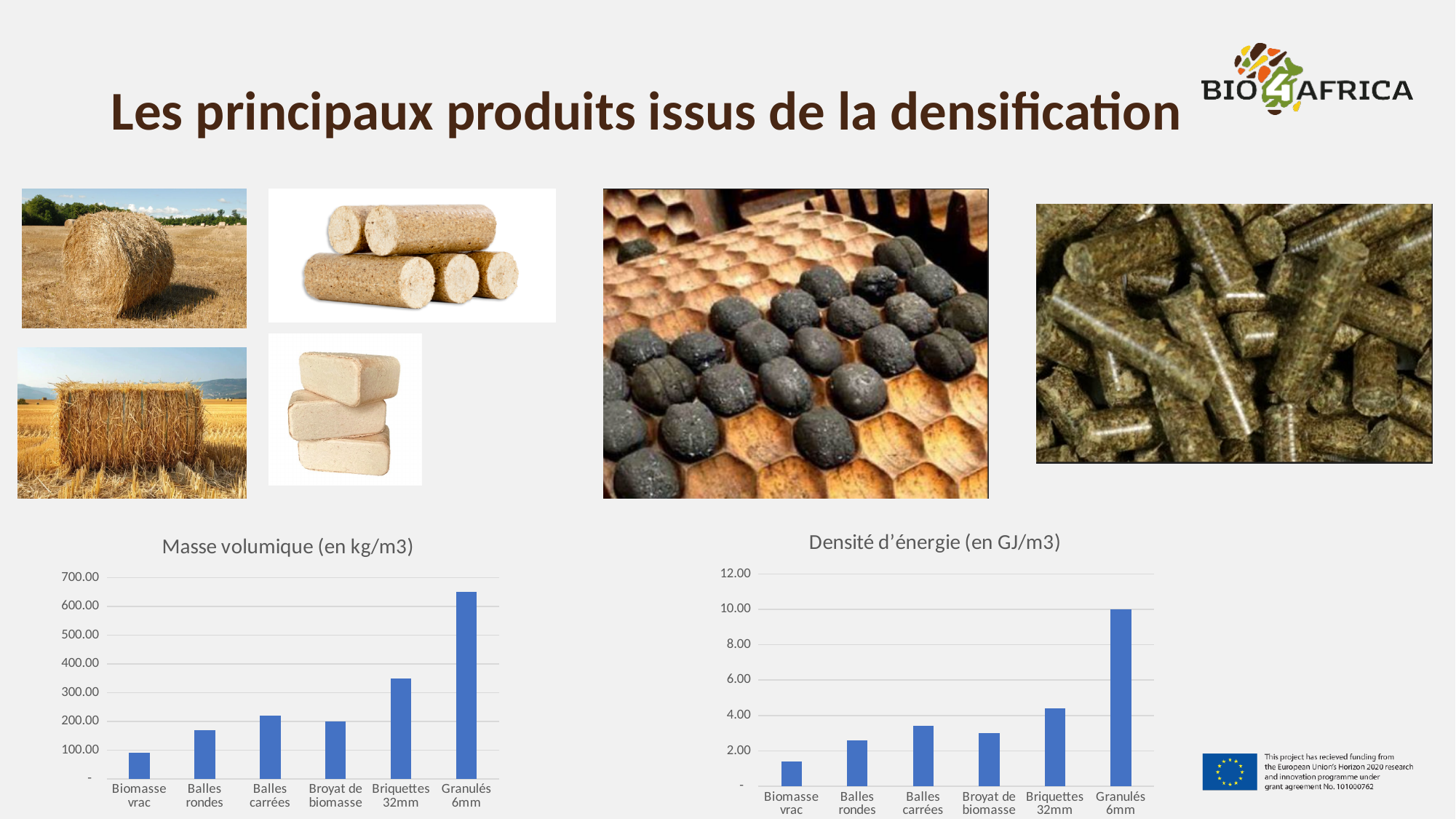
In the 'Densité d'énergie (en GJ/m3)' chart, which category has the lowest value? Biomasse vrac In the 'Densité d'énergie (en GJ/m3)' chart, which category has the highest value? Granulés 6mm In the 'Densité d'énergie (en GJ/m3)' chart, which is larger, the value for Balles carrées or the value for Balles rondes? Balles carrées In the 'Masse volumique (en kg/m3)' chart, which category has the highest value? Granulés 6mm In the 'Densité d'énergie (en GJ/m3)' chart, is the value for Briquettes 32mm greater or less than 4.00? greater In the 'Masse volumique (en kg/m3)' chart, is the value for Granulés 6mm greater or less than 600.00? greater In the 'Masse volumique (en kg/m3)' chart, how many categories are shown on the x axis? 6 In the 'Masse volumique (en kg/m3)' chart, which is larger, the value for Briquettes 32mm or the value for Balles carrées? Briquettes 32mm What kind of chart is the 'Masse volumique (en kg/m3)' chart? bar chart What kind of chart is the 'Densité d'énergie (en GJ/m3)' chart? bar chart In the 'Masse volumique (en kg/m3)' chart, which category has the lowest value? Biomasse vrac